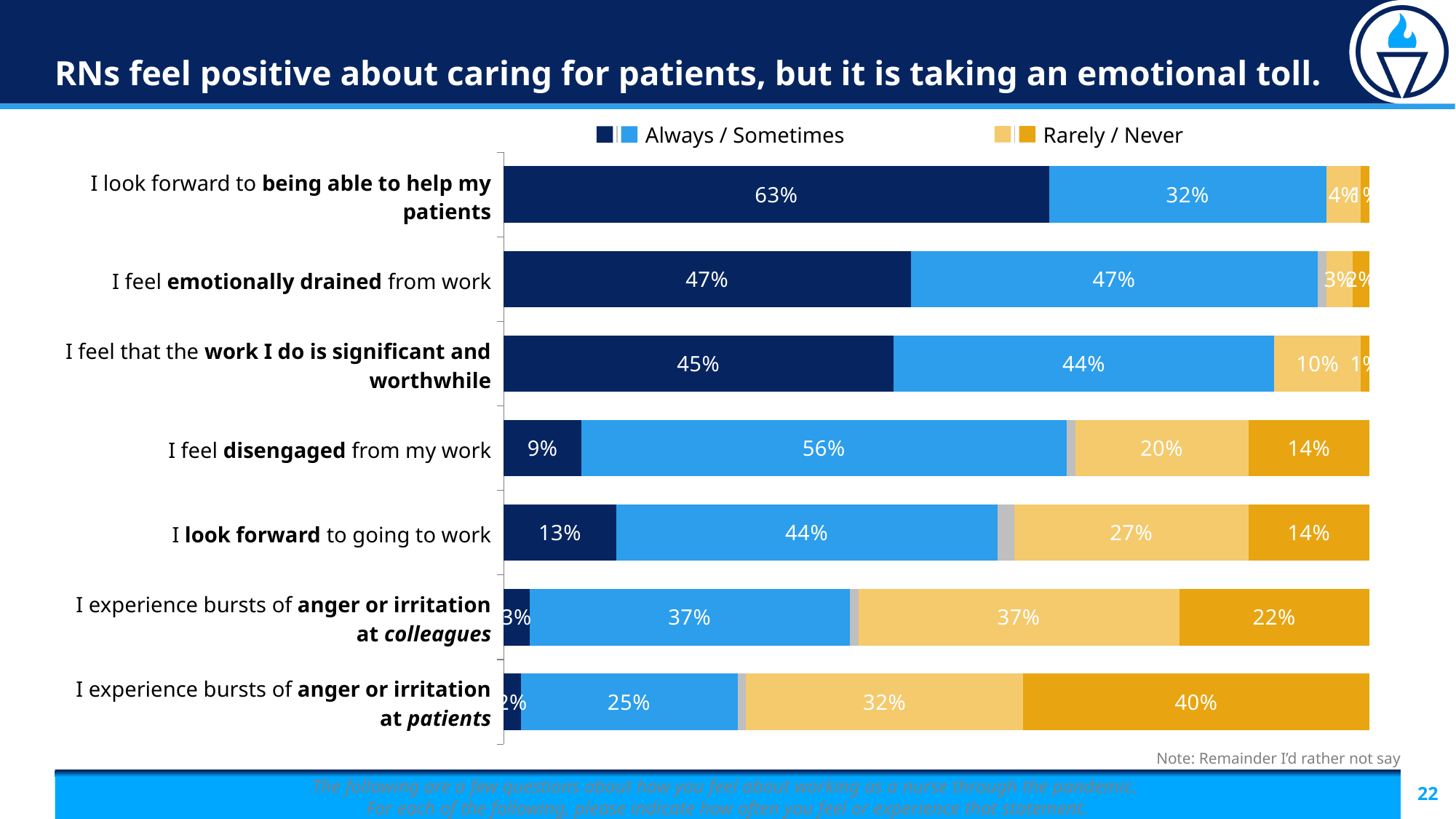
Which is larger: the 'Always' value for 'I feel emotionally drained from work' or the 'Always' value for 'I feel that the work I do is significant and worthwhile'? I feel emotionally drained from work What percentage of RNs say they 'Always' look forward to being able to help their patients (the dark blue segment)? 63% What is the 'Sometimes' (light blue) value for 'I feel disengaged from my work'? 56% According to the note on the slide, what does the remainder of each bar represent? I'd rather not say What is the 'Rarely' (light yellow) value for 'I look forward to going to work'? 27% What percentage of RNs say they 'Never' experience bursts of anger or irritation at patients (the dark yellow segment)? 40% How many statements are shown in the chart? 7 Which statement has the smallest 'Always' (dark blue) segment? I experience bursts of anger or irritation at patients How many percentage points higher is the 'Never' value for anger or irritation at patients than for anger or irritation at colleagues? 18 percentage points What are the two legend entries shown above the chart? Always / Sometimes and Rarely / Never What type of chart is shown on the slide? Stacked bar chart Which statement has the largest 'Always' (dark blue) segment? I look forward to being able to help my patients